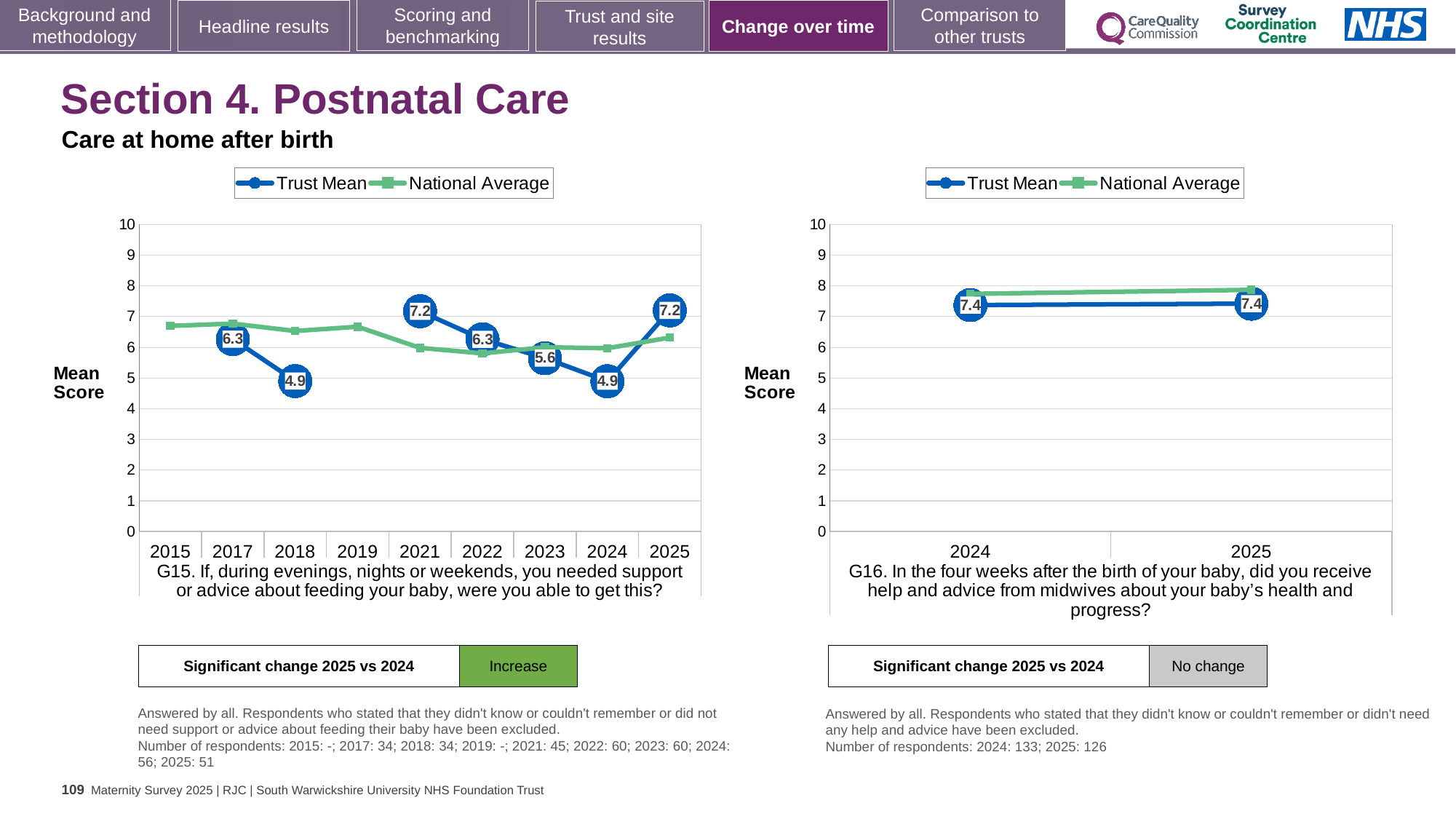
In the left chart (G15), how many series does the legend list? 2 In the left chart (G15), what is the Trust Mean value for 2025? 7.2 In the left chart (G15), is the National Average value for 2015 greater or less than 6? greater In the right chart (G16), what is the Trust Mean value for 2024? 7.4 In the left chart (G15), what is the Trust Mean value for 2018? 4.9 In the right chart (G16), which is higher in 2025, the Trust Mean or the National Average? National Average In the left chart (G15), what is the difference between the Trust Mean for 2025 and the Trust Mean for 2024? 2.3 In the right chart (G16), does the Trust Mean rise, fall or stay the same from 2024 to 2025? Stays the same What does the 'Significant change 2025 vs 2024' box below the left chart (G15) say? Increase In the left chart (G15), which is larger, the Trust Mean for 2023 or the Trust Mean for 2024? 2023 What kind of chart is the left chart (G15)? Line chart In the left chart (G15), how many years are shown on the x axis? 9